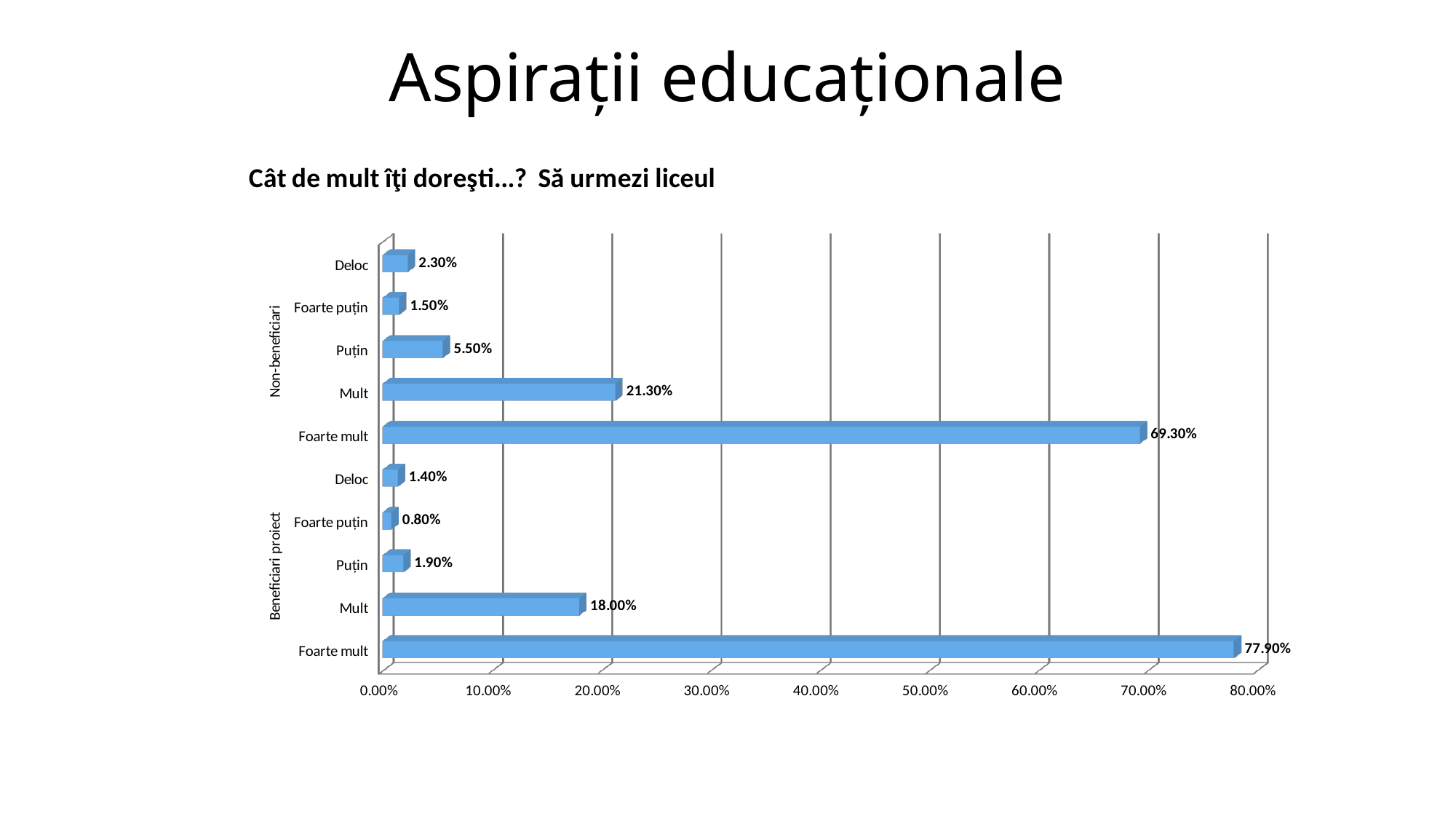
What is the difference between 'Foarte mult' for Beneficiari proiect and 'Foarte mult' for Non-beneficiari? 8.60% What is the value for 'Puțin' in the 'Non-beneficiari' group? 5.50% What kind of chart is shown on the slide? bar chart Is the value for 'Foarte mult' in the Non-beneficiari group greater or less than 60.00%? greater Which is larger: 'Mult' for Non-beneficiari or 'Mult' for Beneficiari proiect? Mult for Non-beneficiari Which bar has the highest value on the chart? Foarte mult (Beneficiari proiect) What is the value for 'Mult' in the 'Non-beneficiari' group? 21.30% Which bar has the lowest value on the chart? Foarte puțin (Beneficiari proiect) How many bars are plotted on the chart? 10 What is the value for 'Foarte mult' in the 'Beneficiari proiect' group? 77.90% What is the value for 'Foarte puțin' in the 'Beneficiari proiect' group? 0.80% What is the title of the chart? Cât de mult îţi doreşti...? Să urmezi liceul